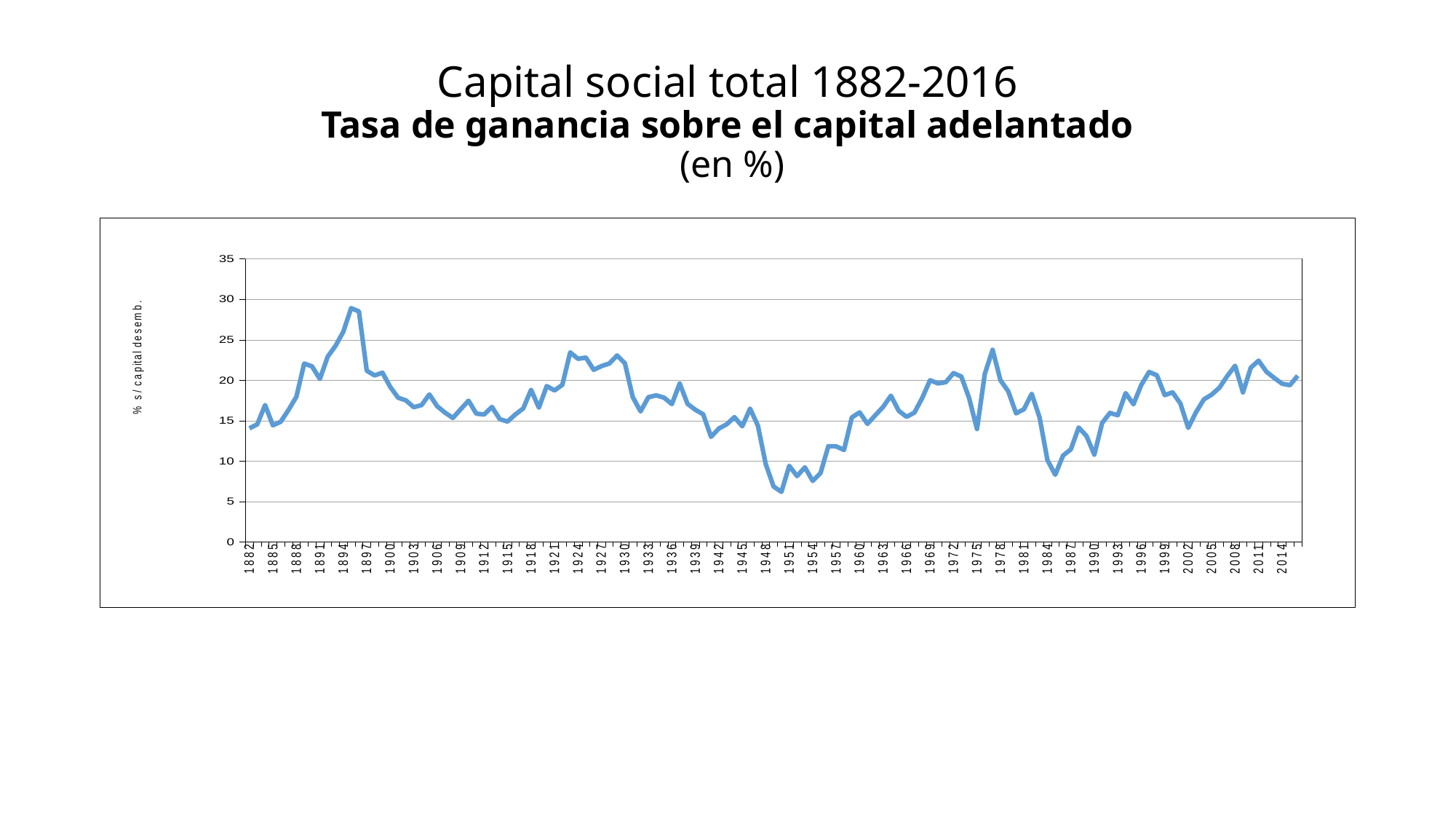
What is the label on the vertical axis of the chart? % s/ capital desemb. Is the value for 1950 greater or less than 10? less Is the value for 1939 greater or less than 15? greater What kind of chart is shown on the slide? line chart Does the line rise or fall between 1945 and 1950? fall Is the value for 1924 greater or less than 20? greater Which is larger, the value for 1924 or the value for 1951? 1924 How many data series are plotted on the chart? 1 Does the line rise or fall between 1984 and 1996? rise